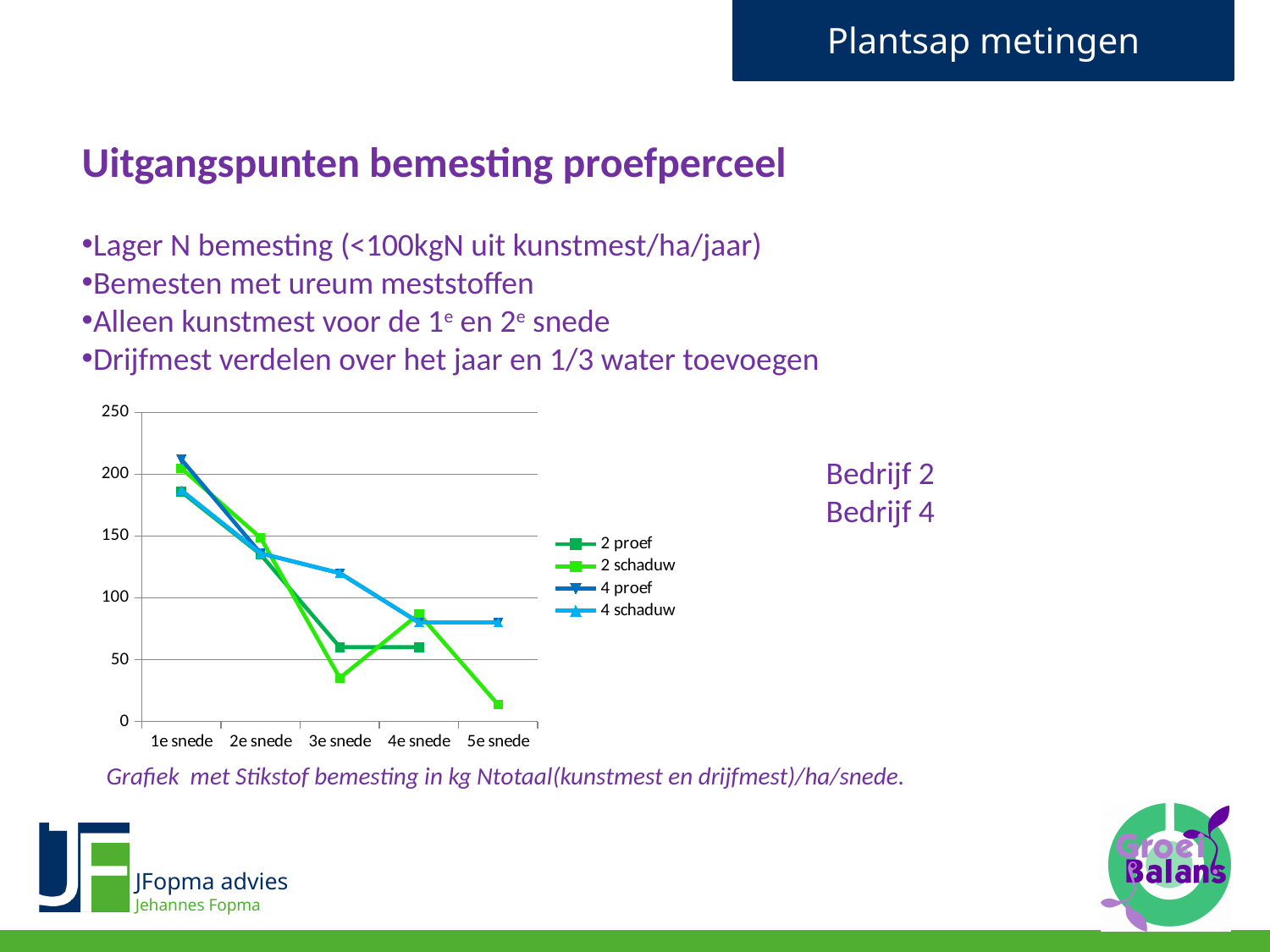
Is the value for 4 schaduw at 3e snede greater or less than 100? greater At 3e snede, which is larger: the value for 4 schaduw or the value for 2 schaduw? 4 schaduw Do the values for 2 proef rise or fall from 1e snede to 3e snede? fall Which series has the lowest value at 5e snede? 2 schaduw Is the value for 4 schaduw at 1e snede greater or less than 200? less Is the value for 4 proef at 1e snede greater or less than 200? greater How many categories (snedes) are shown on the x axis of the chart? 5 What kind of chart is shown on the slide? line chart How many series does the chart legend list? 4 At 5e snede, which is larger: the value for 4 proef or the value for 2 schaduw? 4 proef